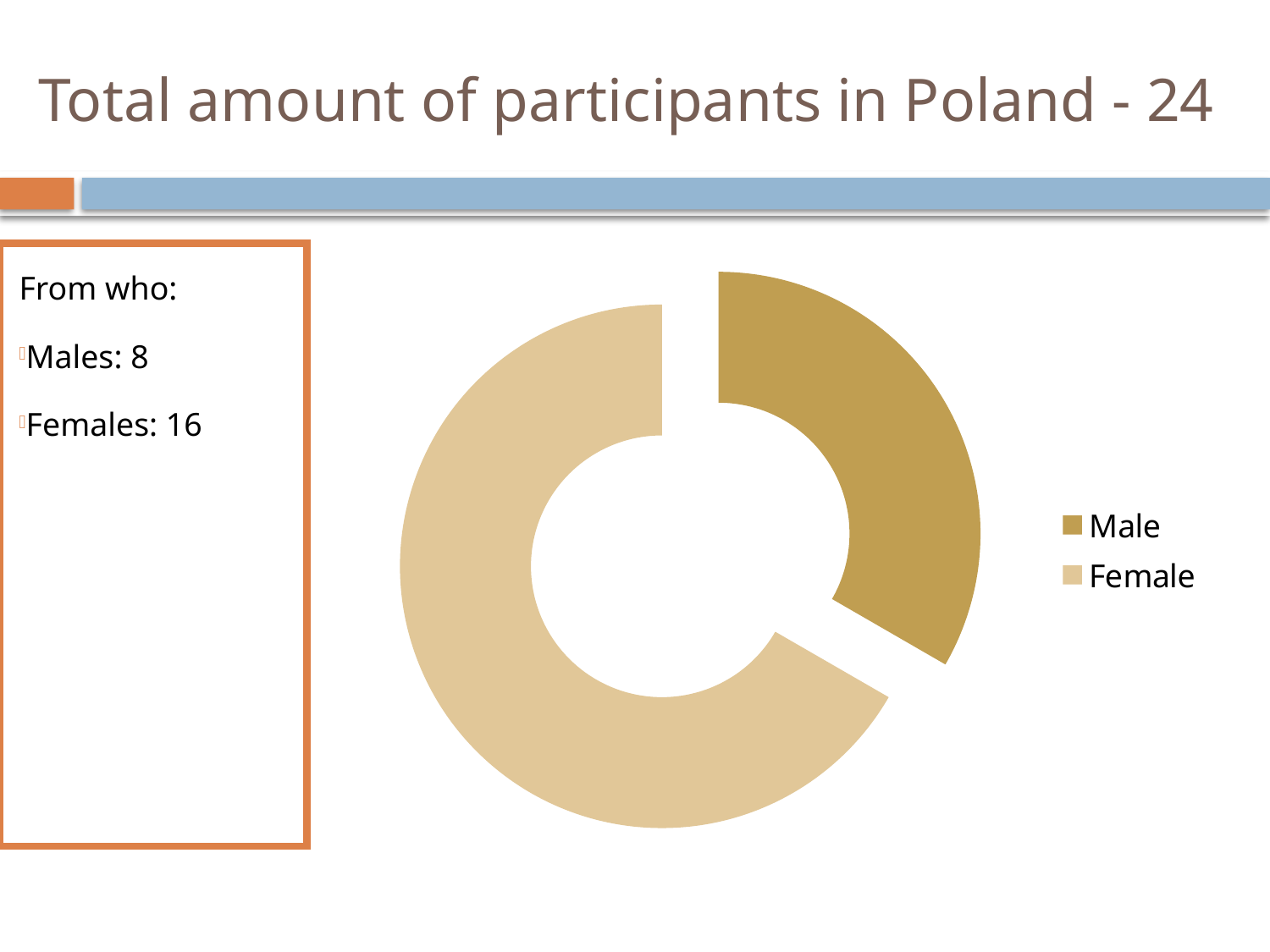
What kind of chart is shown on the slide? doughnut chart Which category has the largest share of the doughnut chart? Female According to the slide, how many female participants are there? 16 Which legend entry is shown in the darker gold colour? Male How many categories does the doughnut chart show? 2 Which category has the smallest share of the doughnut chart? Male How many more female participants are there than male participants? 8 What are the two legend entries of the chart? Male, Female According to the slide, how many male participants are there? 8 What fraction of the doughnut chart does the Female slice represent? two thirds What is the total number of participants shown on the slide? 24 Which category takes up the larger share of the doughnut chart, Male or Female? Female